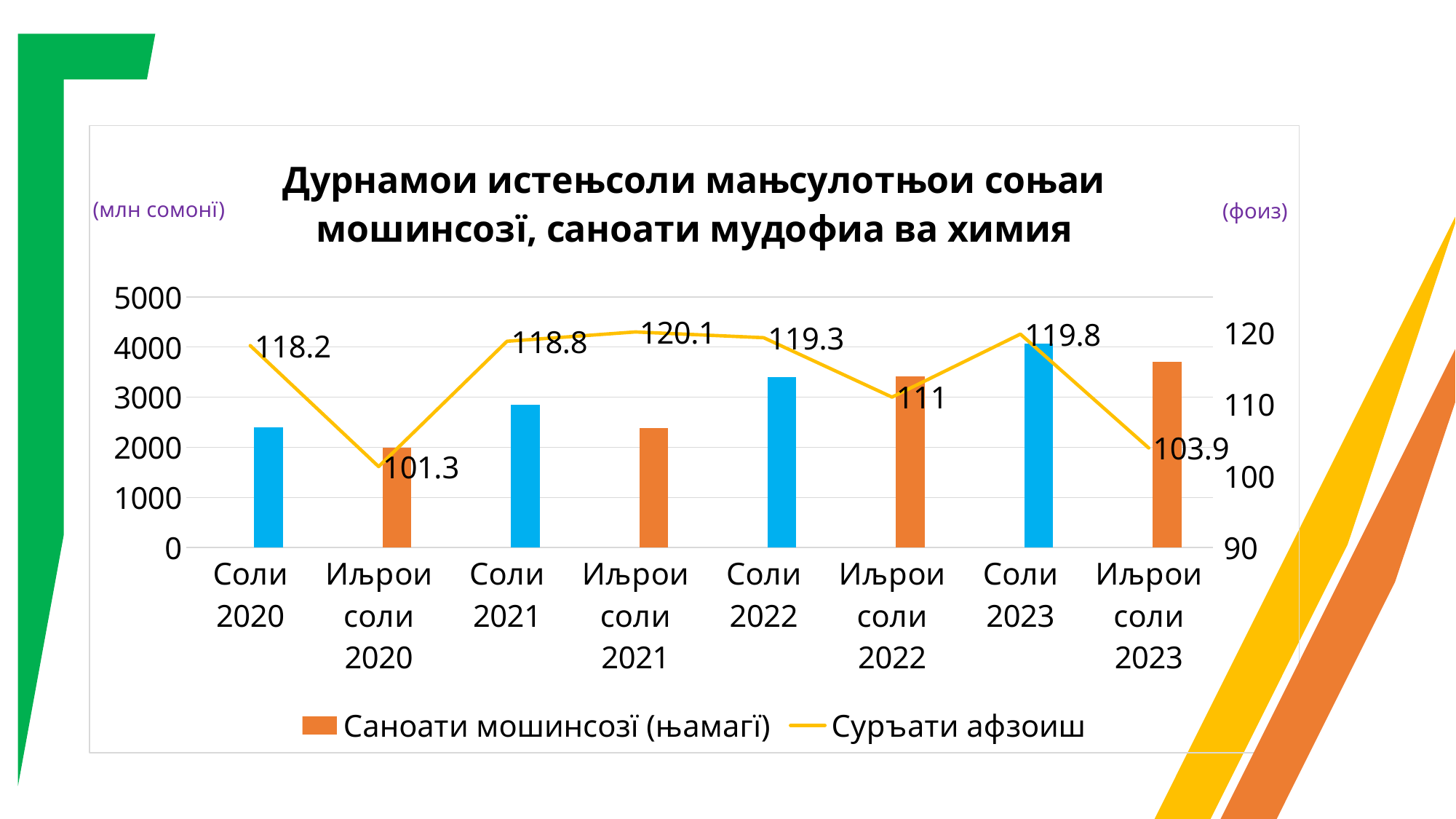
Which is larger, the Суръати афзоиш value for Соли 2022 or for Иљрои соли 2022? Соли 2022 What is the value of the Суръати афзоиш line for Иљрои соли 2021? 120.1 What unit is shown for the left axis? (млн сомонї) What is the value of the Суръати афзоиш line for Иљрои соли 2023? 103.9 For which category is the Суръати афзоиш line highest? Иљрои соли 2021 Is the Саноати мошинсозї (њамагї) bar for Иљрои соли 2020 greater or less than 3000? less What is the value of the Суръати афзоиш line for Соли 2020? 118.2 What is the difference between the Суръати афзоиш values for Соли 2023 and Иљрои соли 2023? 15.9 How many series does the legend list? 2 Is the Саноати мошинсозї (њамагї) bar for Соли 2023 greater or less than 3000? greater How many categories are shown on the x axis? 8 For which category is the Суръати афзоиш line lowest? Иљрои соли 2020